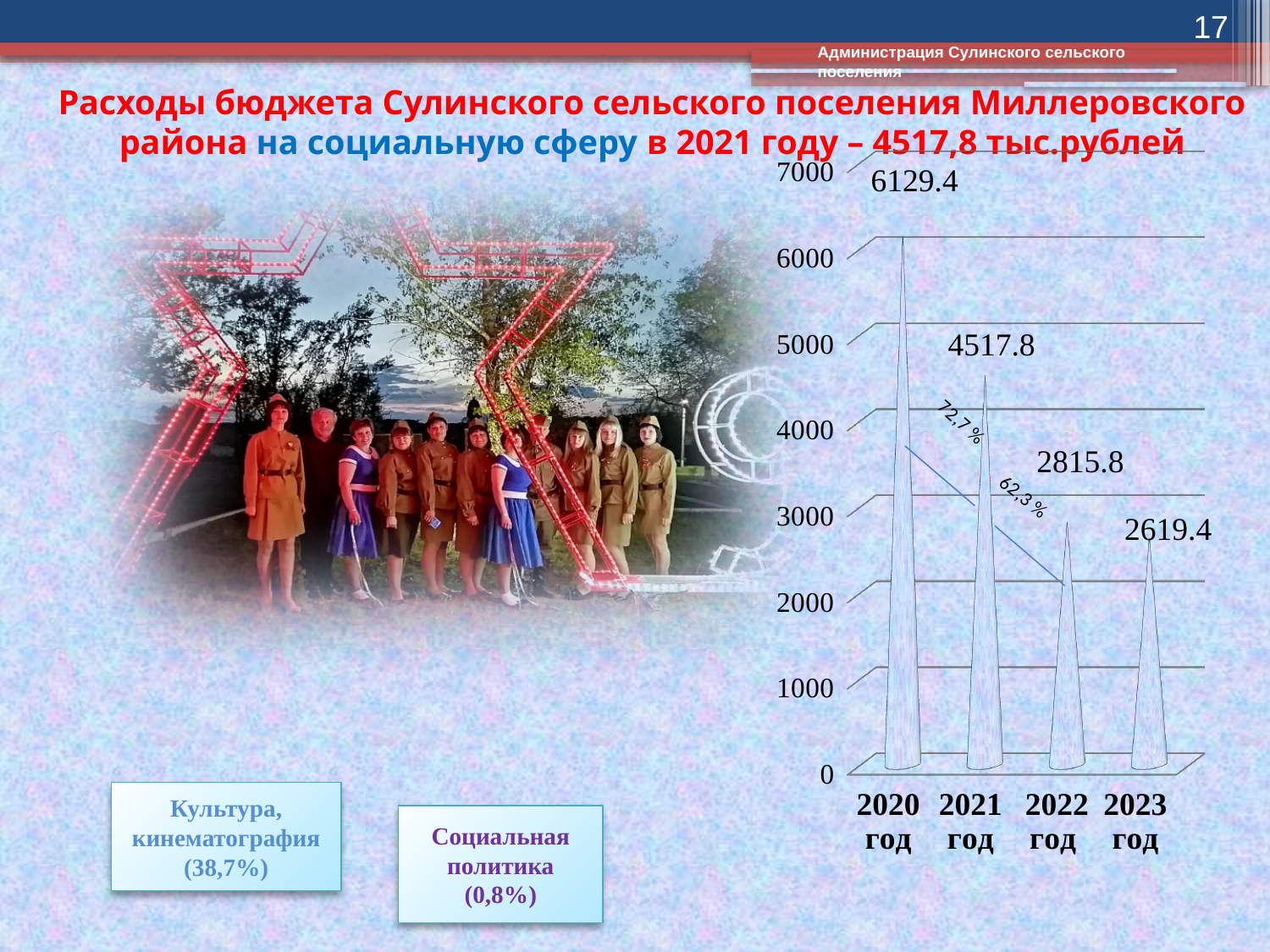
What is the difference between the values for 2021 год and 2022 год? 1702.0 What is the value shown for 2021 год? 4517.8 What is the value shown for 2023 год? 2619.4 How many years are shown on the x axis of the chart? 4 What percentage label is shown between the 2020 год and 2021 год bars? 72.7 % What is the difference between the values for 2020 год and 2021 год? 1611.6 Which is larger, the value for 2021 год or the value for 2022 год? 2021 год What is the value shown for 2020 год? 6129.4 Do the values rise or fall from 2020 год to 2023 год? fall Which year has the highest value on the chart? 2020 год Which year has the lowest value on the chart? 2023 год What is the value shown for 2022 год? 2815.8